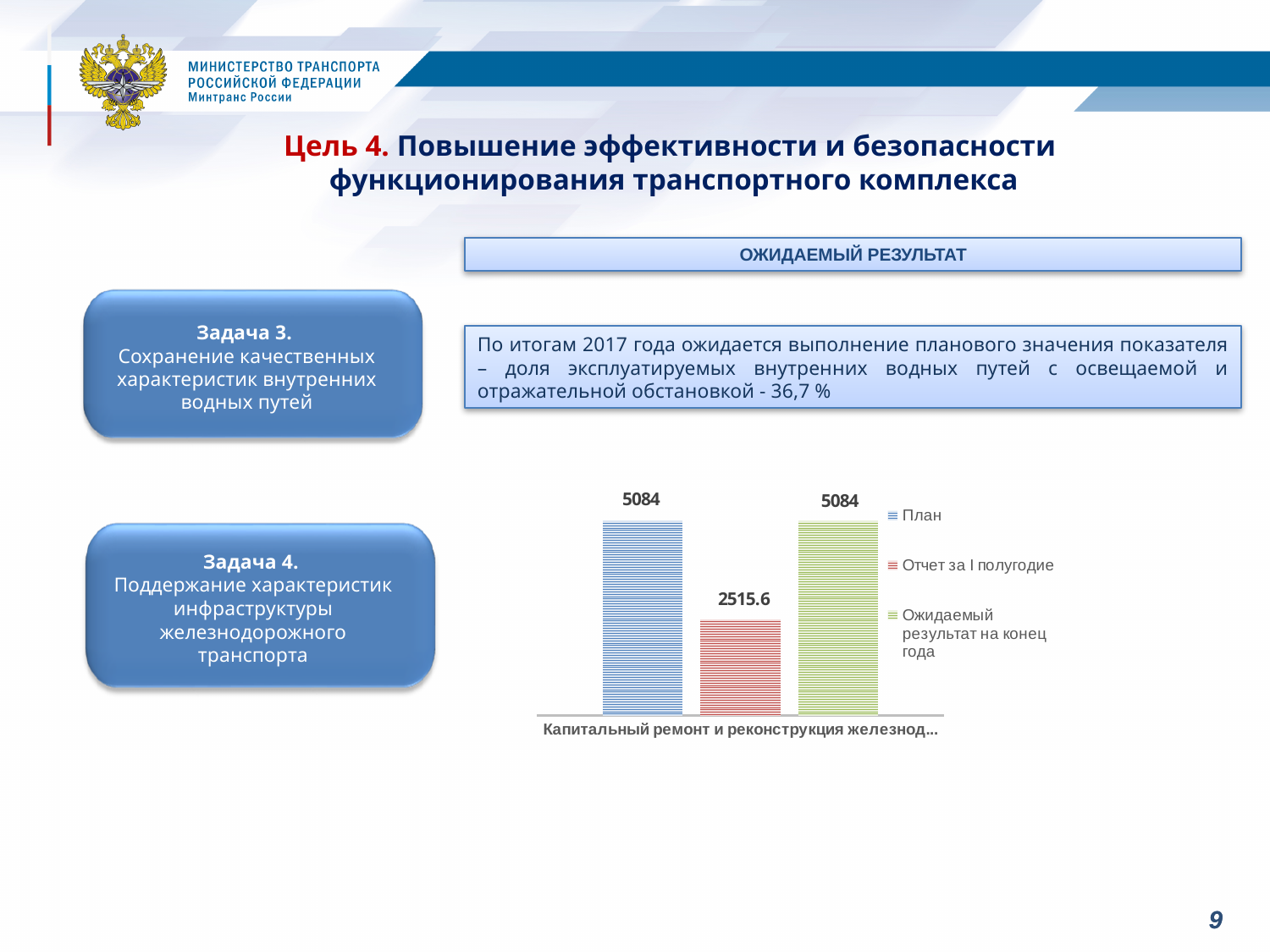
What is the value for the series "Ожидаемый результат на конец года" in the chart? 5084 What kind of chart is shown on the slide? bar chart Which legend entry is shown in green in the chart? Ожидаемый результат на конец года How many bars are plotted in the chart? 3 What is the value for the series "План" in the chart? 5084 How many series does the chart legend list? 3 What is the value for the series "Отчет за I полугодие" in the chart? 2515.6 Is the value for "Отчет за I полугодие" greater or less than the value for "Ожидаемый результат на конец года"? less Which is larger: the value for "План" or the value for "Отчет за I полугодие"? План What colour is the bar for the series "Отчет за I полугодие"? red What is the difference between the "План" value and the "Отчет за I полугодие" value? 2568.4 Which series has the lowest value in the chart? Отчет за I полугодие